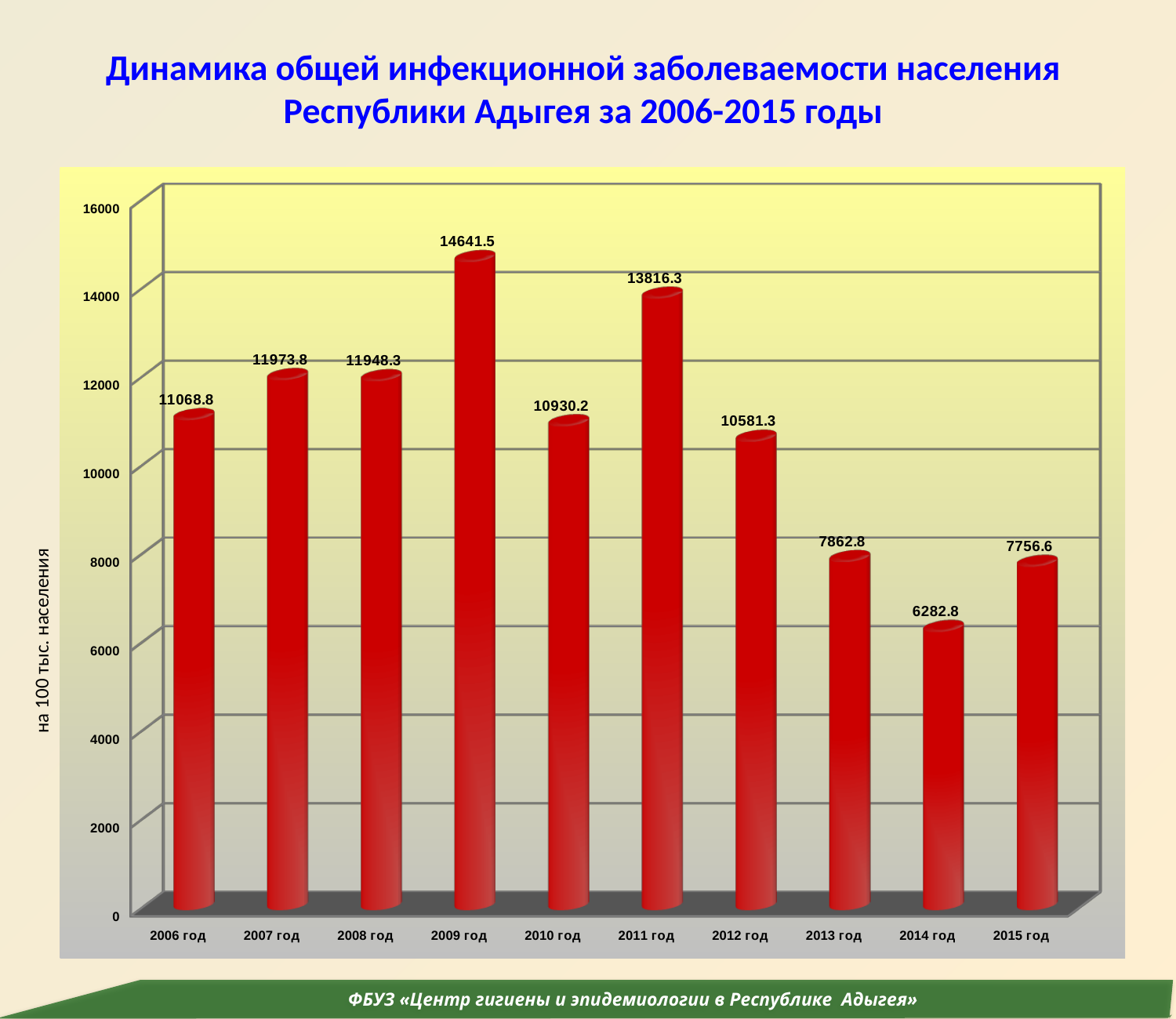
What is the value for 2011 год? 13816.3 Which year has the highest value? 2009 год What is the difference between the values for 2009 год and 2014 год? 8358.7 What kind of chart is shown on the slide? bar chart Which year has the lowest value? 2014 год Which is larger, the value for 2011 год or the value for 2012 год? 2011 год What is the label on the vertical axis? на 100 тыс. населения What is the value for 2009 год? 14641.5 How many years are shown on the x axis? 10 Is the value for 2013 год greater or less than 8000? less What is the value for 2015 год? 7756.6 What is the value for 2014 год? 6282.8